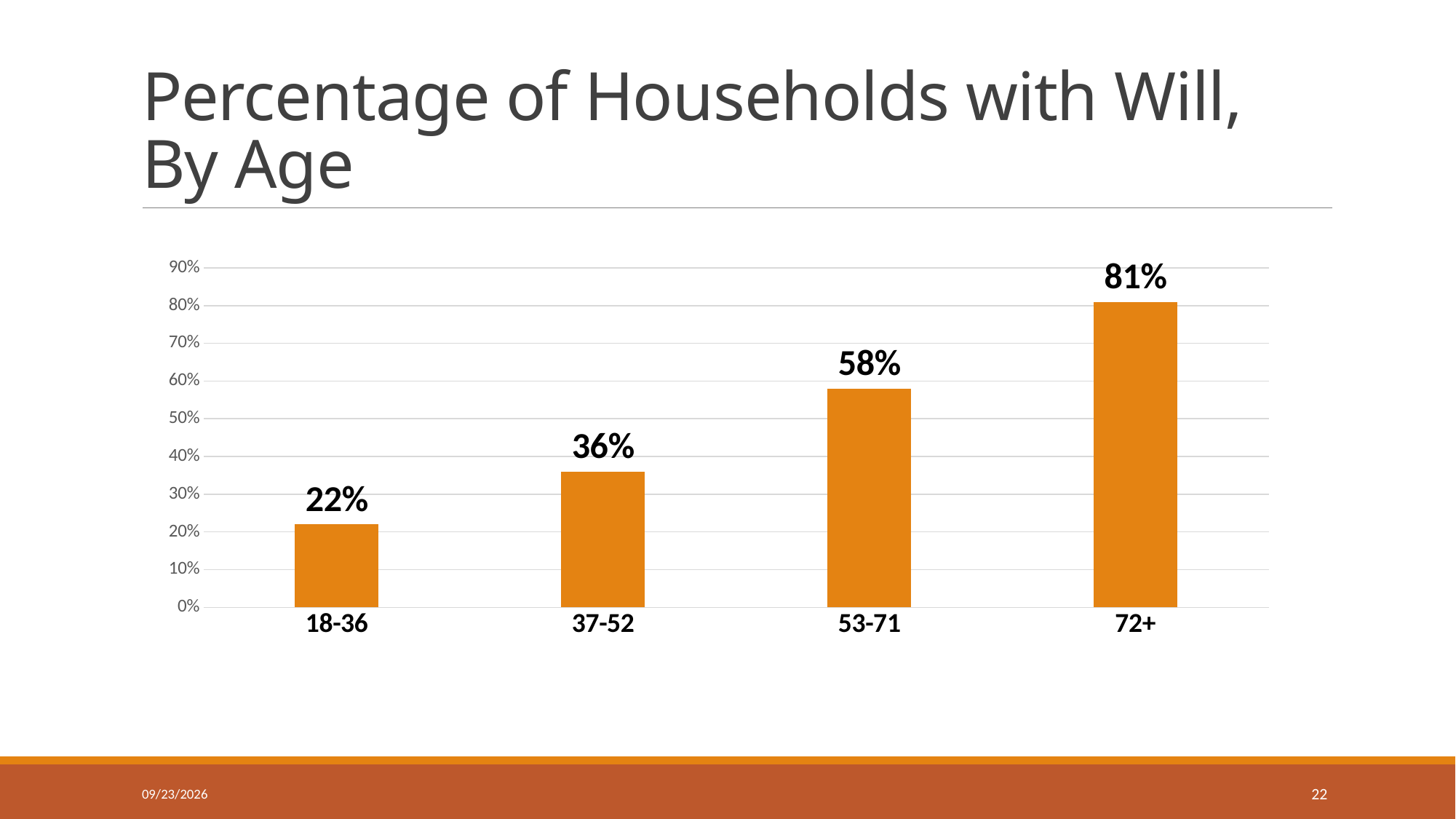
Which has a higher percentage of households with a will, the 37-52 group or the 53-71 group? 53-71 What is the difference in percentage points between the 53-71 and 37-52 age groups? 22 Which age group has the highest percentage of households with a will? 72+ What is the value shown for the 72+ age group? 81% Do the values rise or fall as age increases along the x axis? Rise What kind of chart is shown on the slide? Bar chart What is the difference in percentage points between the 72+ and 18-36 age groups? 59 What is the value shown for the 37-52 age group? 36% What percentage of households aged 53-71 have a will? 58% What percentage of households aged 18-36 have a will? 22% Which age group has the lowest percentage of households with a will? 18-36 How many age groups are shown in the chart? 4